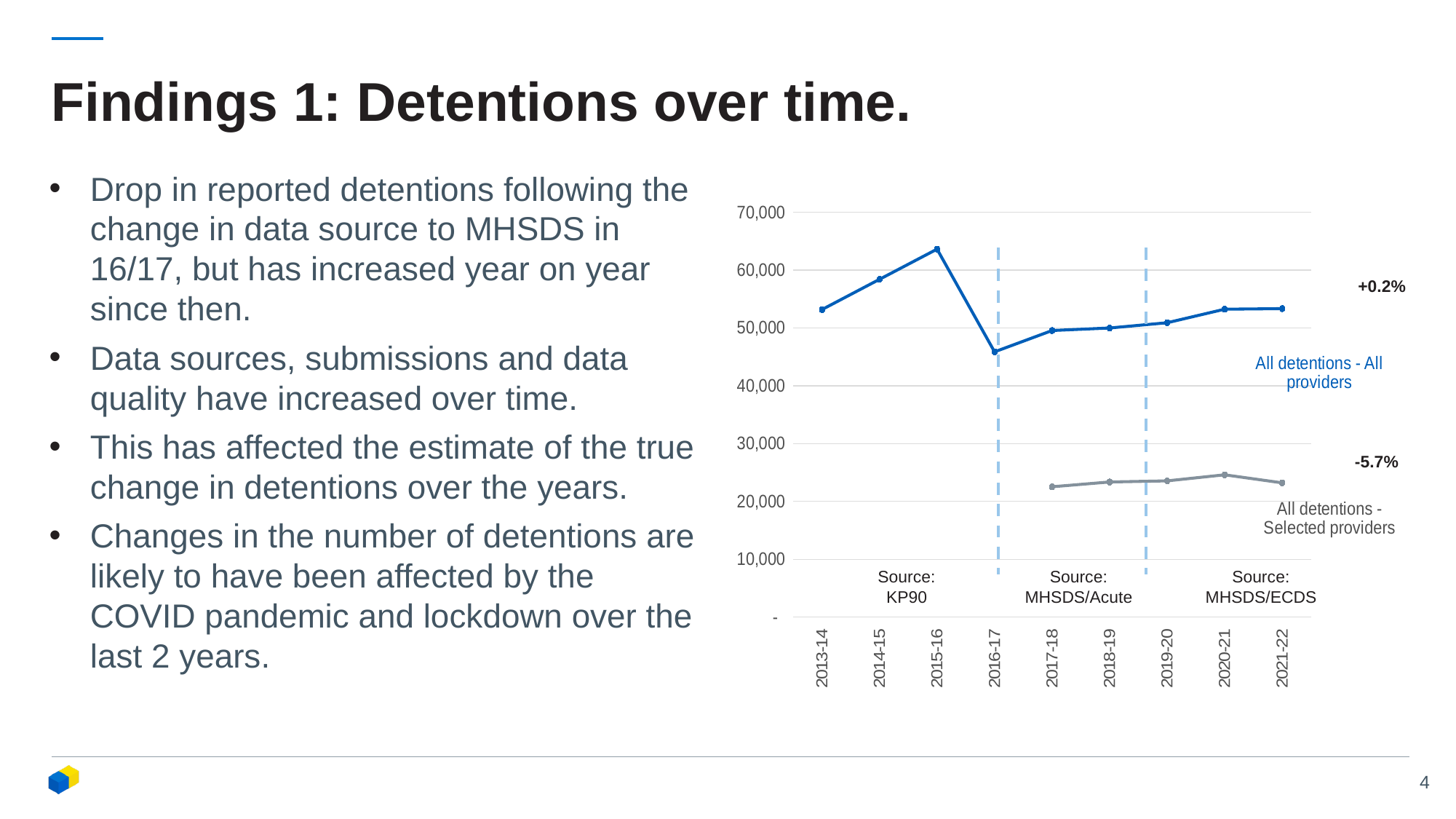
In which year is the 'All detentions - All providers' line at its highest? 2015-16 What kind of chart is shown on the slide? Line chart Does the 'All detentions - All providers' line rise or fall between 2016-17 and 2020-21? Rise How many financial years are shown on the x axis of the chart? 9 Is the value for 'All detentions - All providers' in 2016-17 greater or less than 50,000? less What percentage change is annotated next to the 'All detentions - Selected providers' line? -5.7% In which year is the 'All detentions - All providers' line at its lowest? 2016-17 Is the value for 'All detentions - Selected providers' in 2020-21 greater or less than 30,000? less How many data series (lines) are plotted on the chart? 2 For 'All detentions - All providers', which year has the larger value: 2014-15 or 2016-17? 2014-15 Is the value for 'All detentions - All providers' in 2015-16 greater or less than 60,000? greater In which year is the 'All detentions - Selected providers' line at its highest? 2020-21